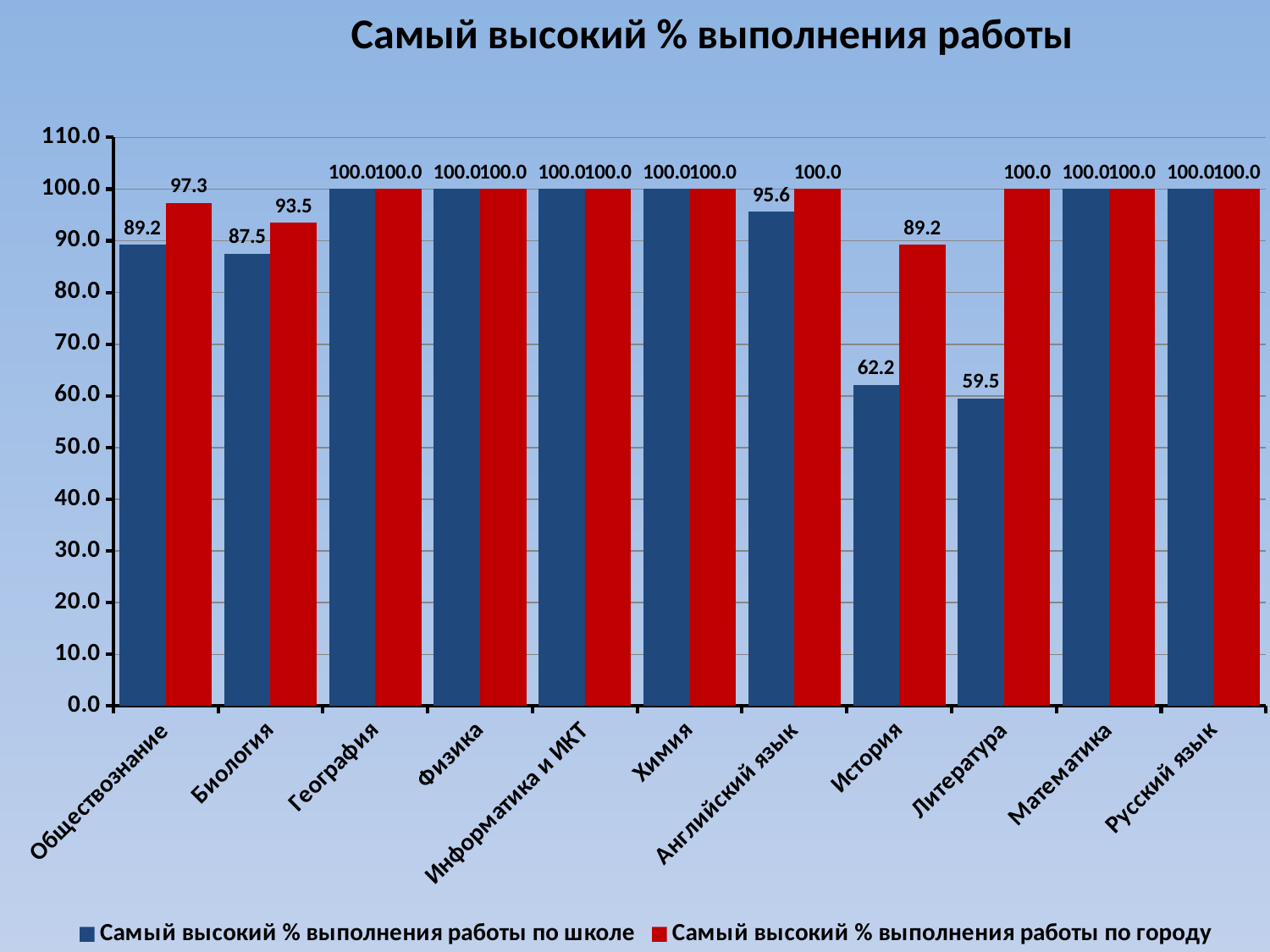
What is the value for История in the series 'Самый высокий % выполнения работы по городу'? 89.2 What kind of chart is shown on the slide? bar chart How many categories are shown on the x axis? 11 What is the value for Литература in the series 'Самый высокий % выполнения работы по школе'? 59.5 What is the difference between the 'по городу' and 'по школе' values for История? 27.0 Is the 'по школе' value for История greater or less than 70.0? less Which is larger for Английский язык: the 'по школе' value or the 'по городу' value? по городу Which category has the lowest value in the series 'Самый высокий % выполнения работы по городу'? История Which category has the lowest value in the series 'Самый высокий % выполнения работы по школе'? Литература What is the difference between the 'по городу' and 'по школе' values for Биология? 6.0 How many series does the legend list? 2 What is the value for Обществознание in the series 'Самый высокий % выполнения работы по школе'? 89.2